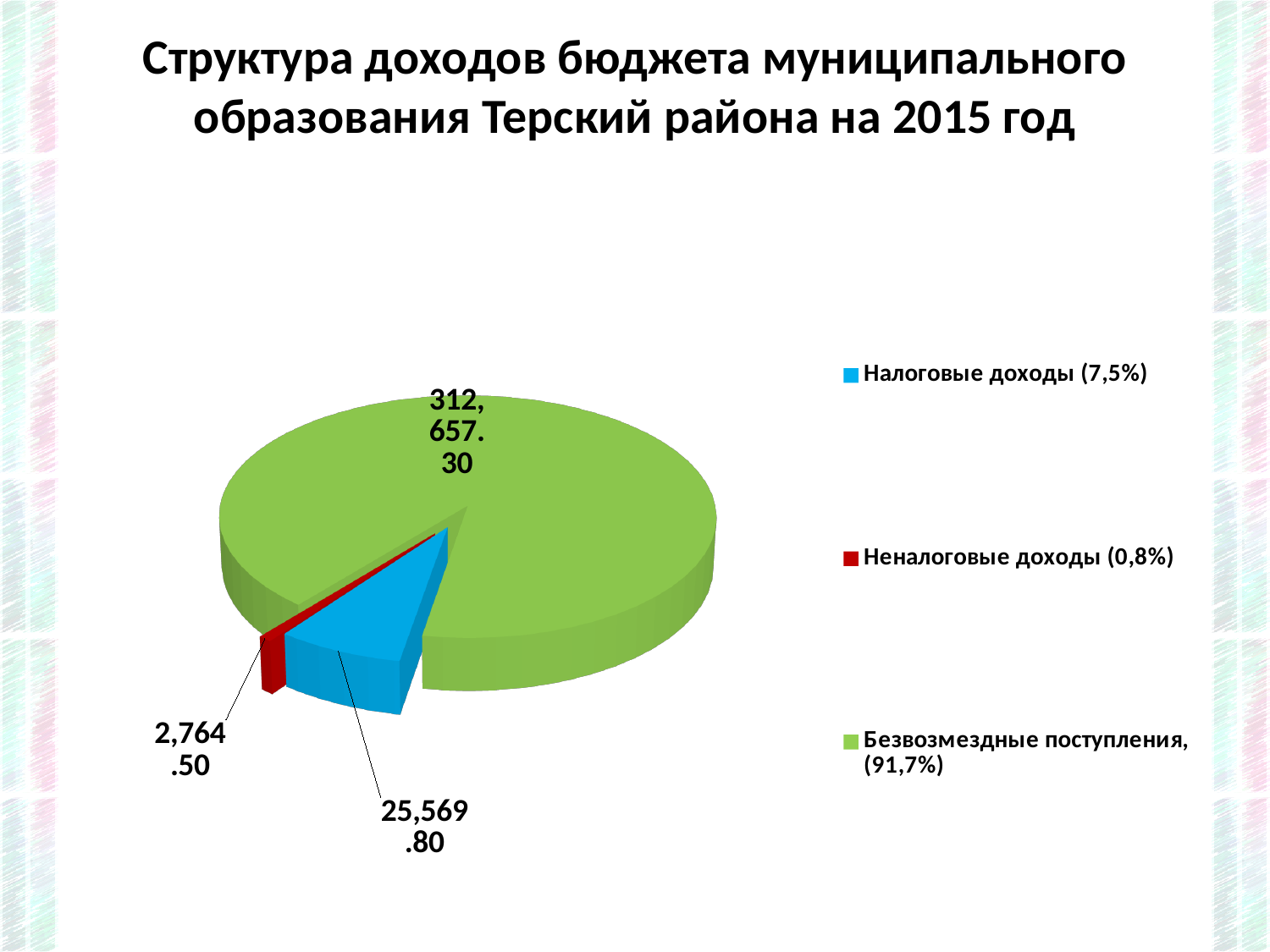
Which category has the largest slice of the pie? Безвозмездные поступления What is the value for Неналоговые доходы? 2,764.50 What share of the pie does Безвозмездные поступления represent? 91,7% What is the value for Безвозмездные поступления? 312,657.30 What colour is the slice for Неналоговые доходы? Red Which is larger, the value for Налоговые доходы or the value for Неналоговые доходы? Налоговые доходы What share of the pie does Налоговые доходы represent? 7,5% What kind of chart is shown on the slide? Pie chart What is the difference between the values for Налоговые доходы and Неналоговые доходы? 22,805.30 How many slices does the pie chart have? 3 Which category has the smallest slice of the pie? Неналоговые доходы What is the value for Налоговые доходы? 25,569.80